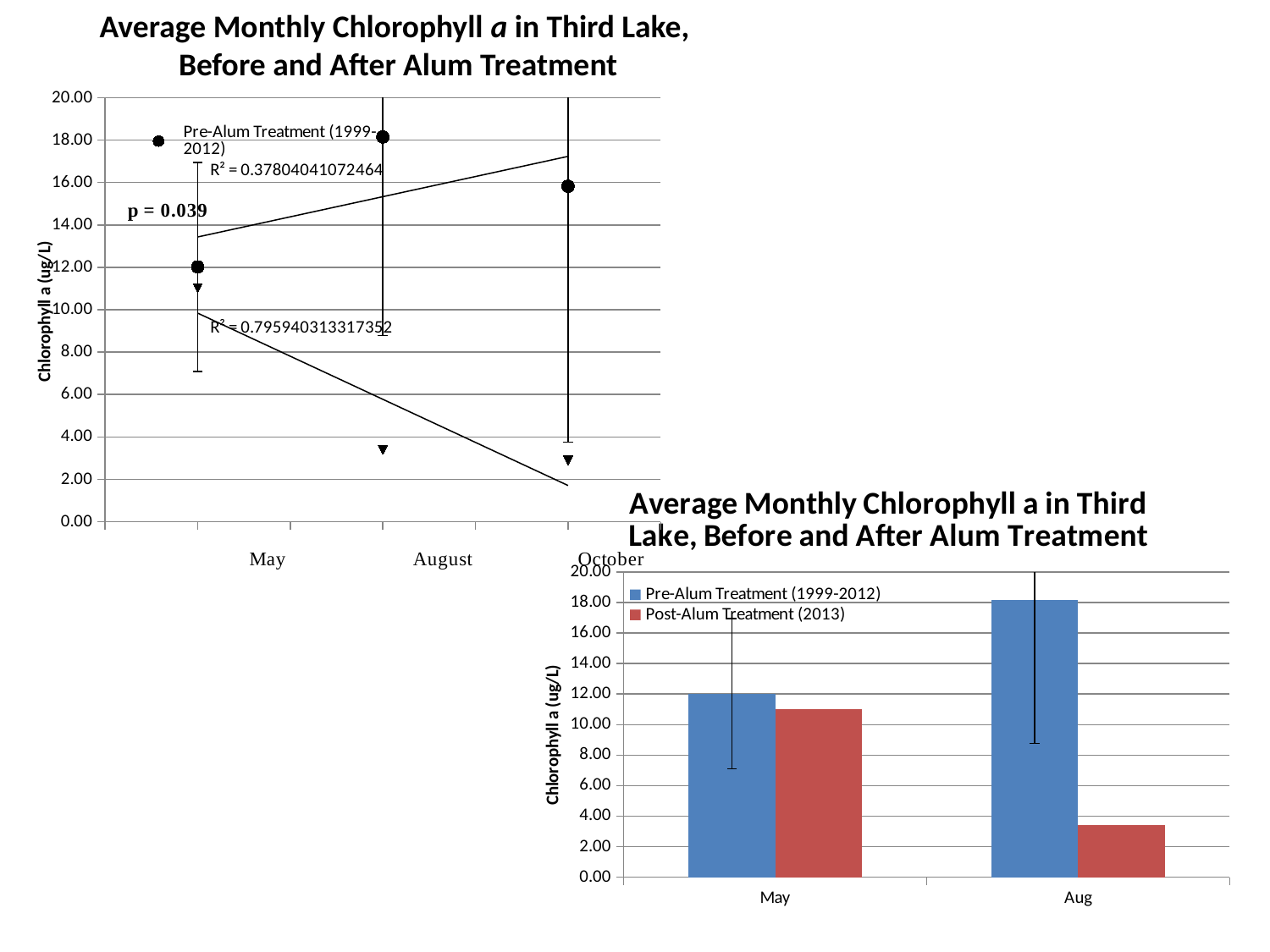
In the bottom-right bar chart, which series has the larger value for Aug, Pre-Alum Treatment (1999-2012) or Post-Alum Treatment (2013)? Pre-Alum Treatment (1999-2012) What is the y-axis label of the bottom-right bar chart? Chlorophyll a (ug/L) In the bottom-right bar chart, which category has the lowest Post-Alum Treatment (2013) value? Aug In the bottom-right bar chart, which category has the highest Pre-Alum Treatment (1999-2012) value? Aug How many categories are shown on the x axis of the bottom-right bar chart? 2 What p value is printed on the top-left scatter chart? p = 0.039 What kind of chart is the bottom-right chart titled "Average Monthly Chlorophyll a in Third Lake, Before and After Alum Treatment"? bar chart In the bottom-right bar chart, is the Pre-Alum Treatment (1999-2012) value for Aug greater or less than 16.00? greater In the bottom-right bar chart, is the Post-Alum Treatment (2013) value for Aug greater or less than 4.00? less How many series does the legend of the bottom-right bar chart list? 2 In the top-left scatter chart, is the Pre-Alum Treatment (1999-2012) value for August greater or less than 16.00? greater In the bottom-right bar chart, does the Post-Alum Treatment (2013) series rise or fall from May to Aug? fall